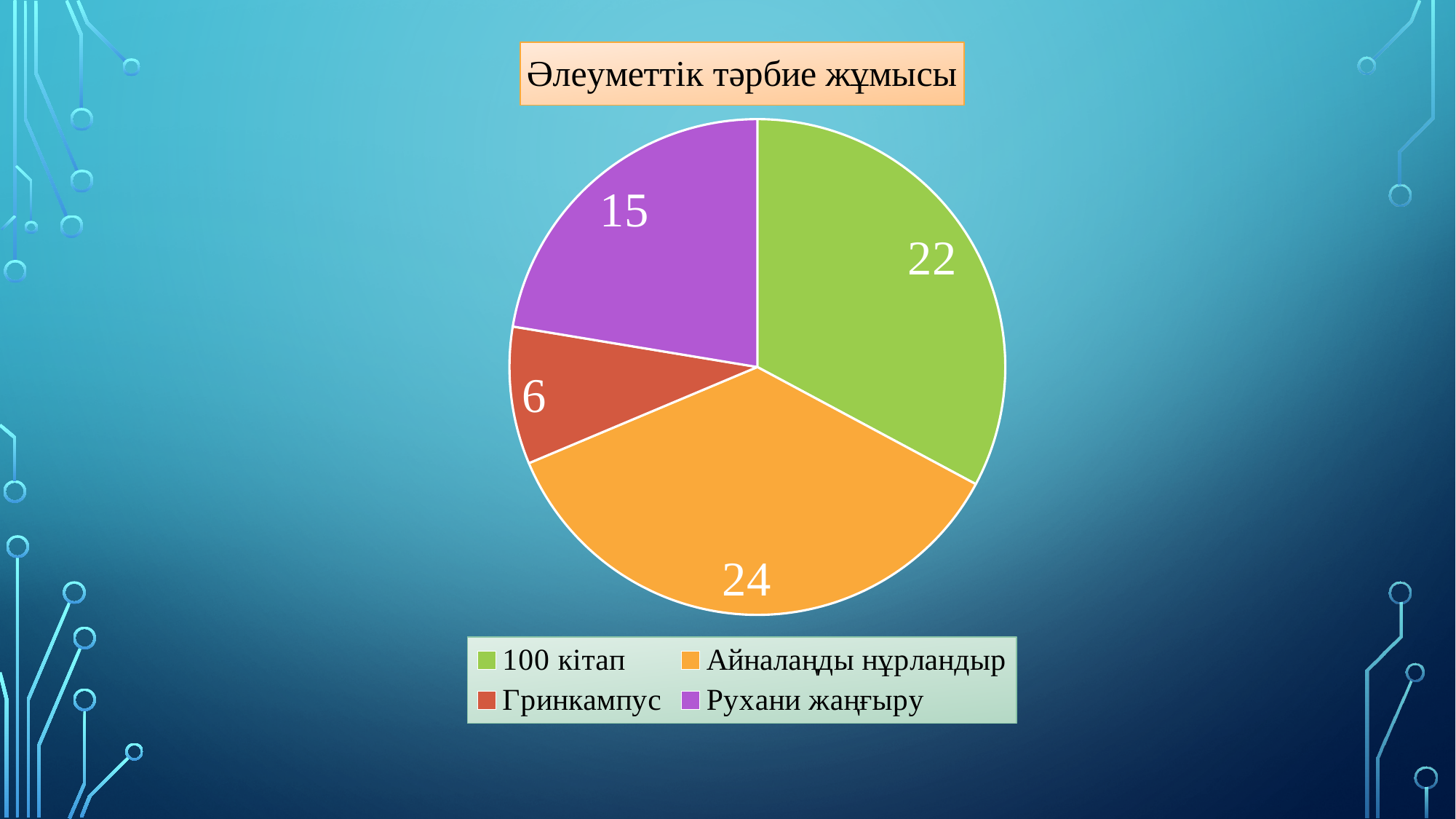
What is the value for 100 кітап? 22 What is the difference between the values for Айналаңды нұрландыр and Рухани жаңғыру? 9 Which category has the largest slice? Айналаңды нұрландыр What is the title of the chart? Әлеуметтік тәрбие жұмысы Which category has the smallest slice? Гринкампус What is the value for Гринкампус? 6 Which is larger, the value for 100 кітап or the value for Рухани жаңғыру? 100 кітап What is the value for Рухани жаңғыру? 15 What is the total of all slices in the pie chart? 67 What type of chart is shown on the slide? pie chart How many slices does the pie chart have? 4 What is the value for Айналаңды нұрландыр? 24